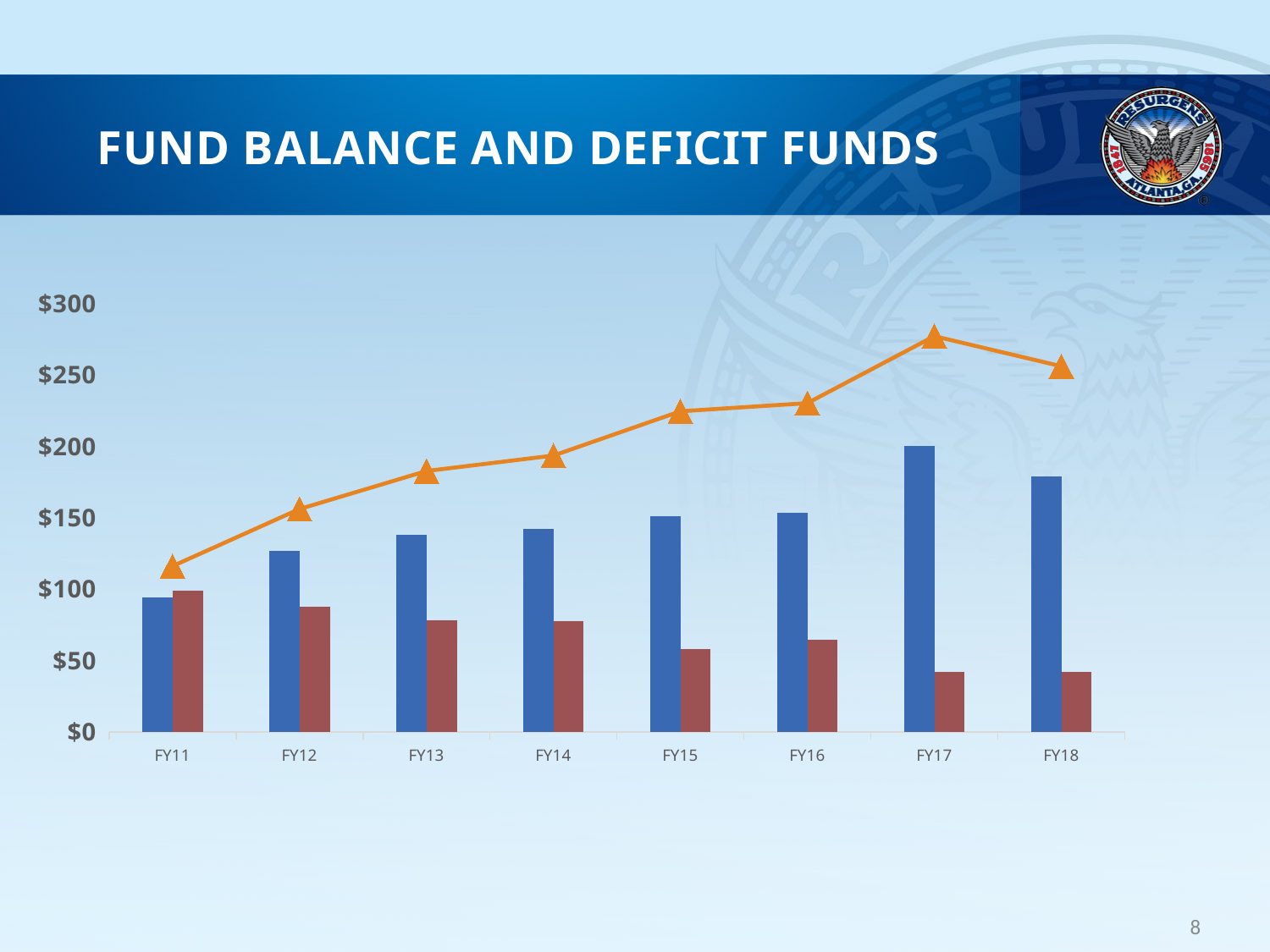
What is the title of the chart? FUND BALANCE AND DEFICIT FUNDS Is the red bar for FY17 greater or less than $50? less Do the red bars generally rise or fall from FY11 to FY18? fall Which fiscal year has the tallest blue bar? FY17 Is the blue bar for FY17 greater or less than $150? greater What kind of chart is shown on the slide? Bar chart with a line series Is the orange line value for FY17 greater or less than $250? greater Which fiscal year has the highest point on the orange line? FY17 Which fiscal year has the tallest red bar? FY11 Which fiscal year has the shortest blue bar? FY11 Which is larger, the blue bar for FY17 or the blue bar for FY18? FY17 How many fiscal years are shown on the x axis? 8